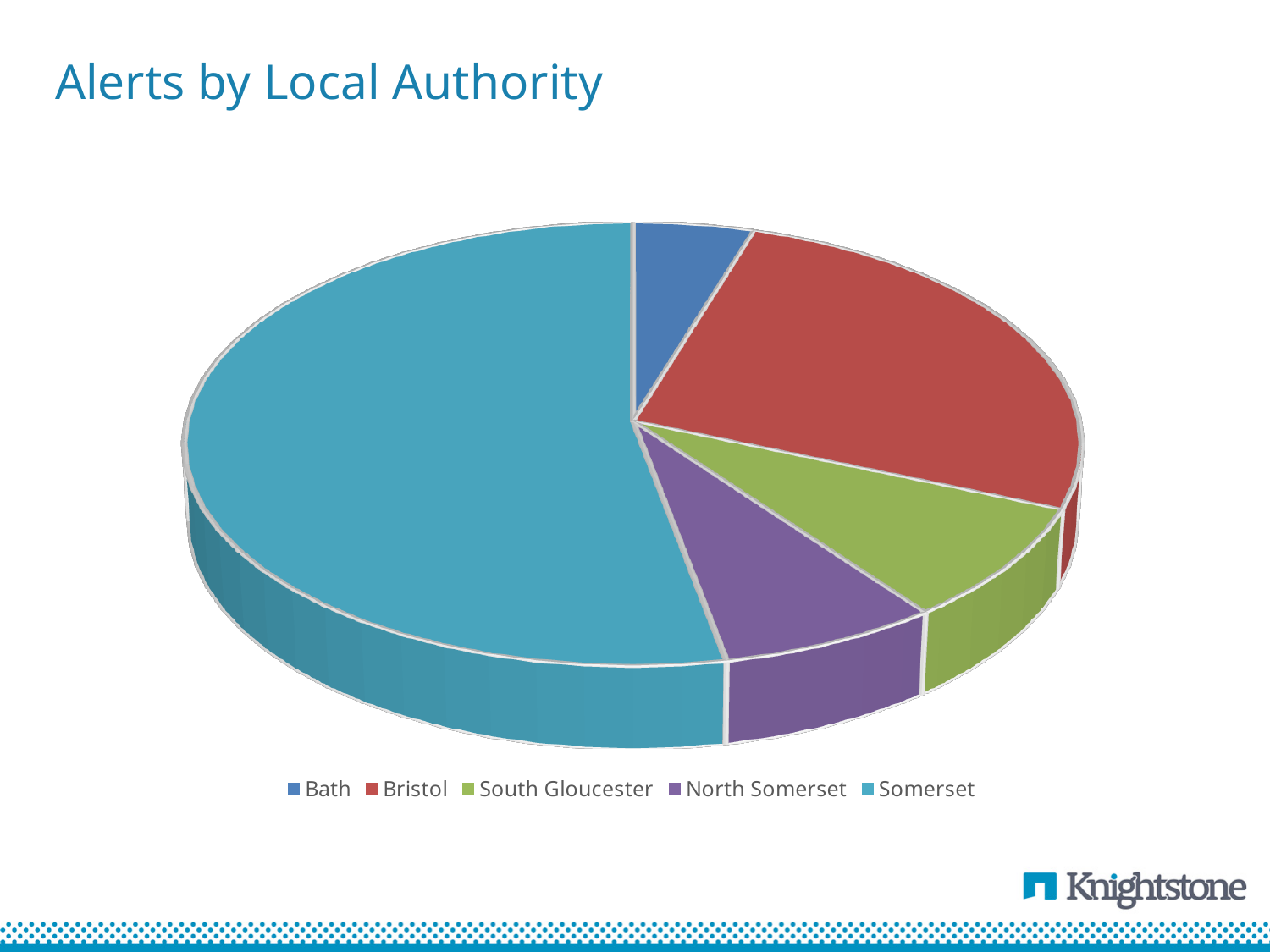
What kind of chart is shown on the slide? pie chart Which local authority has the largest share of alerts? Somerset How many local authorities are shown in the pie chart? 5 How many entries does the legend list? 5 Is Somerset's share of the pie greater or less than half? greater Which has a larger share of alerts, Somerset or Bristol? Somerset What is the title of the chart? Alerts by Local Authority Which colour represents Bristol in the pie chart? red Which has a larger share of alerts, Bristol or Bath? Bristol Which has a larger share of alerts, Bristol or North Somerset? Bristol Which local authority has the smallest share of alerts? Bath